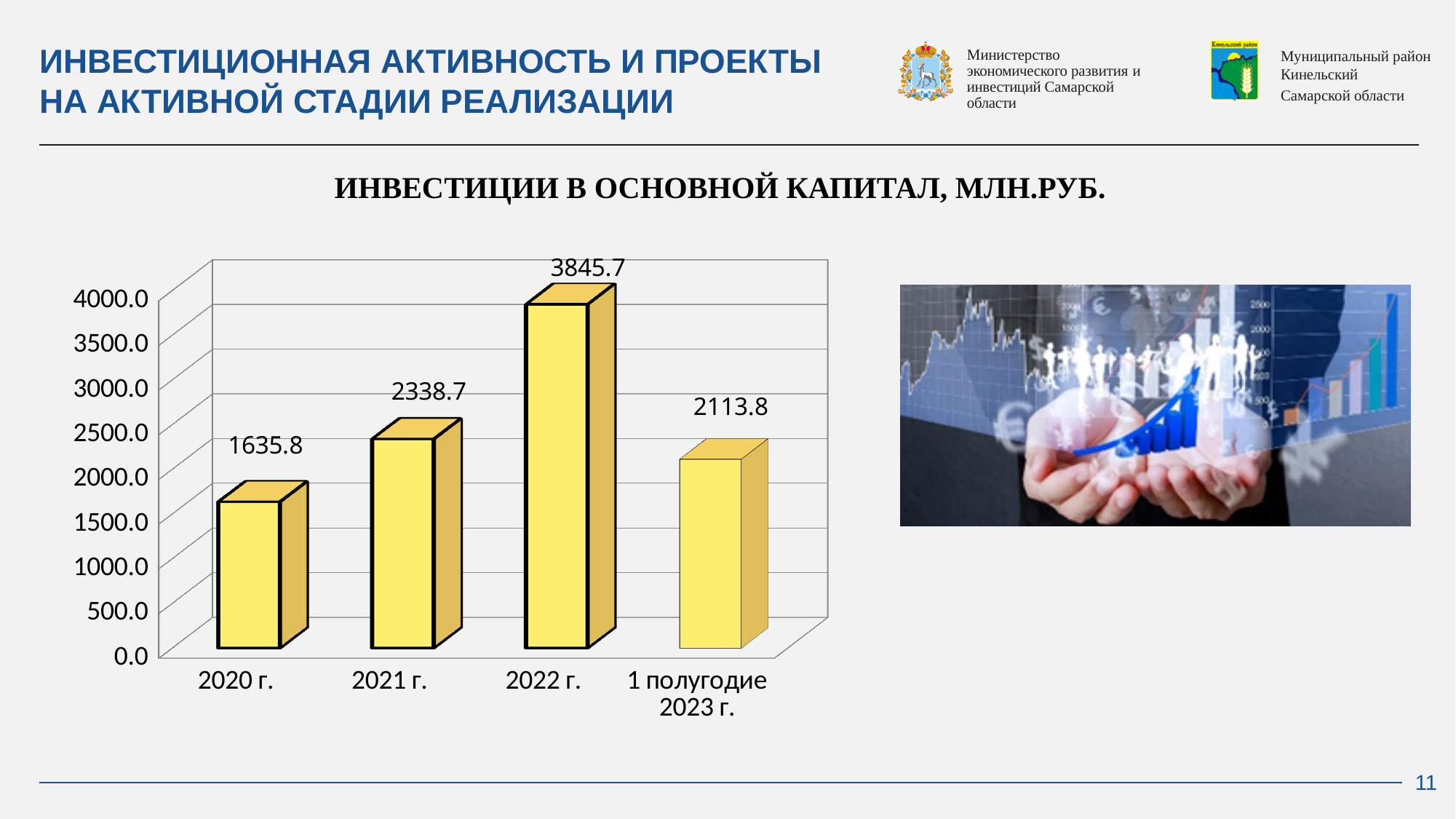
What is the difference between the values for 2021 г. and 2020 г.? 702.9 Which category has the lowest value? 2020 г. Which category has the highest value? 2022 г. What is the difference between the values for 2022 г. and 2021 г.? 1507.0 Which is larger, the value for 2021 г. or the value for 1 полугодие 2023 г.? 2021 г. How many categories are shown on the chart? 4 What is the value for 2020 г.? 1635.8 What is the value for 2022 г.? 3845.7 What kind of chart is shown on the slide? Bar chart What is the value for 2021 г.? 2338.7 What is the title of the chart? ИНВЕСТИЦИИ В ОСНОВНОЙ КАПИТАЛ, МЛН.РУБ. What is the value for 1 полугодие 2023 г.? 2113.8